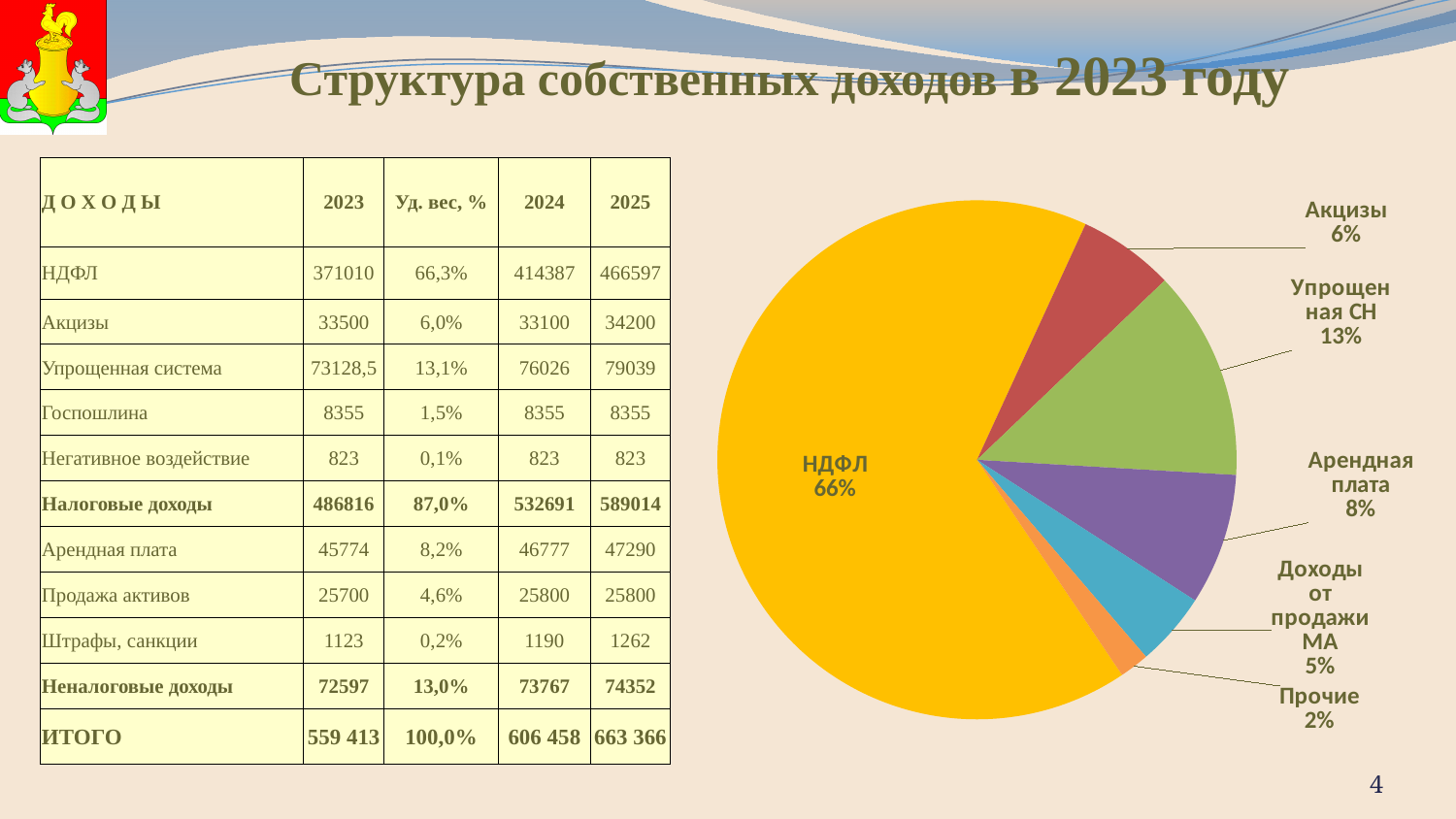
How many slices does the pie chart have? 6 Which slice of the pie is the smallest? Прочие Which is larger in the pie chart, Упрощенная СН or Арендная плата? Упрощенная СН What share of the pie does НДФЛ have? 66% What kind of chart is shown on the slide? pie chart What share of the pie does Прочие have? 2% What share of the pie does Арендная плата have? 8% Which slice of the pie is the largest? НДФЛ What is the difference in percentage points between the Упрощенная СН slice and the Акцизы slice? 7